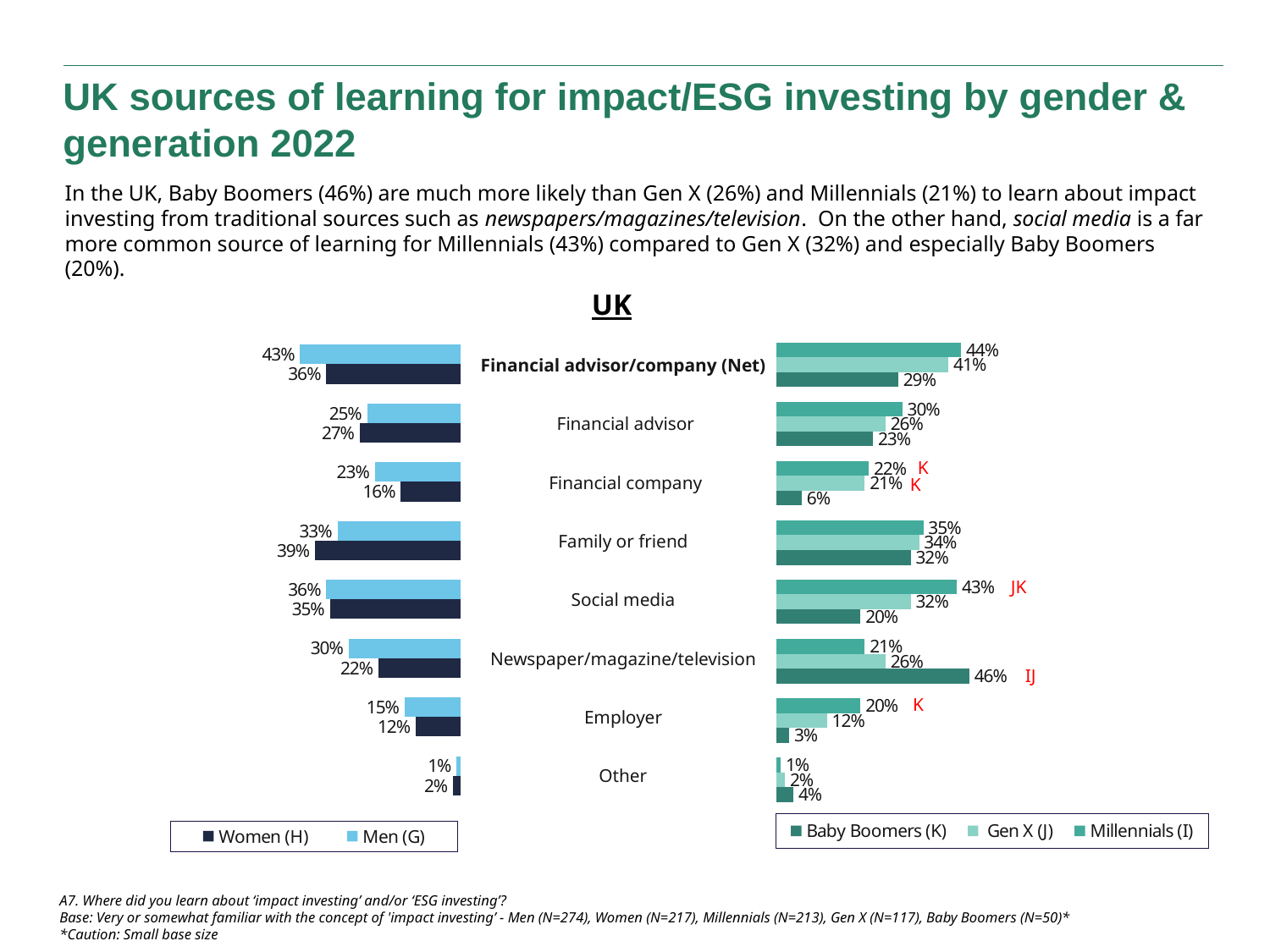
In the right chart (by generation), what is the value for Baby Boomers for Newspaper/magazine/television? 46% In the left chart (by gender), which category has the highest value for Men? Financial advisor/company (Net) In the left chart (by gender), which is larger for Family or friend, Women or Men? Women In the left chart (by gender), what is the value for Men for Family or friend? 33% In the right chart (by generation), what is the difference between Millennials and Baby Boomers for Social media? 23 percentage points In the right chart (by generation), what is the value for Millennials for Social media? 43% What kind of chart is the right chart (by generation)? Bar chart In the right chart (by generation), which generation has the lowest value for Financial company? Baby Boomers In the left chart (by gender), what is the difference between Men and Women for Financial company? 7 percentage points In the left chart (by gender), what is the value for Women for Newspaper/magazine/television? 22% How many series does the legend of the right chart (by generation) list? 3 How many categories are shown in the left chart (by gender)? 8